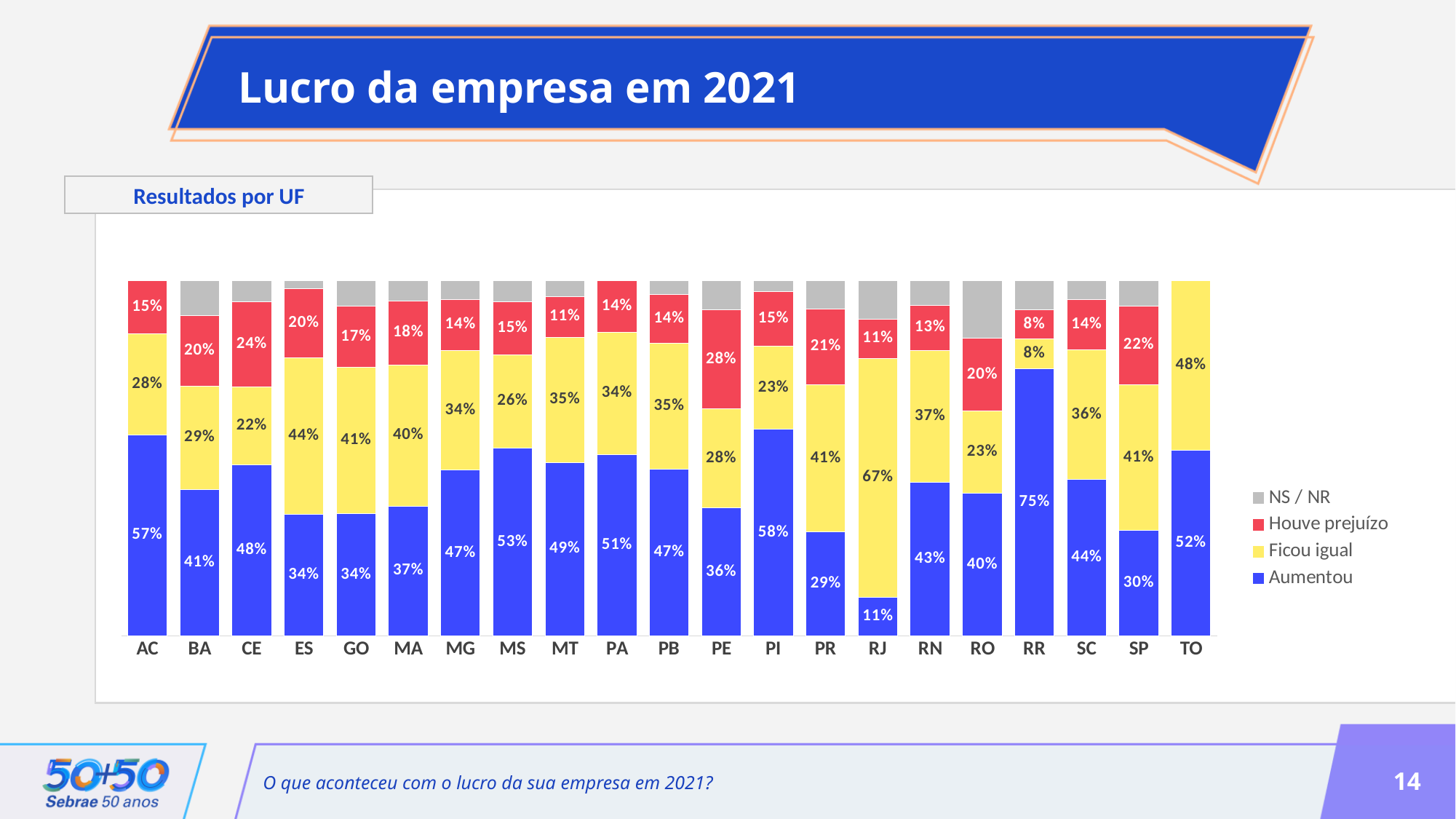
What type of chart is shown on the slide? Stacked bar chart What is the 'Aumentou' value for AC? 57% How many series does the legend list? 4 What is the 'Houve prejuízo' value for PE? 28% Which UF has the lowest 'Aumentou' value? RJ What is the 'Ficou igual' value for RJ? 67% How many UFs (categories) are shown on the x axis? 21 Which UF has the highest 'Aumentou' value? RR What is the difference between the 'Aumentou' values for AC and SP? 27 percentage points Which UF has the highest 'Houve prejuízo' value? PE Which legend entry is shown in yellow? Ficou igual Which has a larger 'Aumentou' value, PI or MS? PI